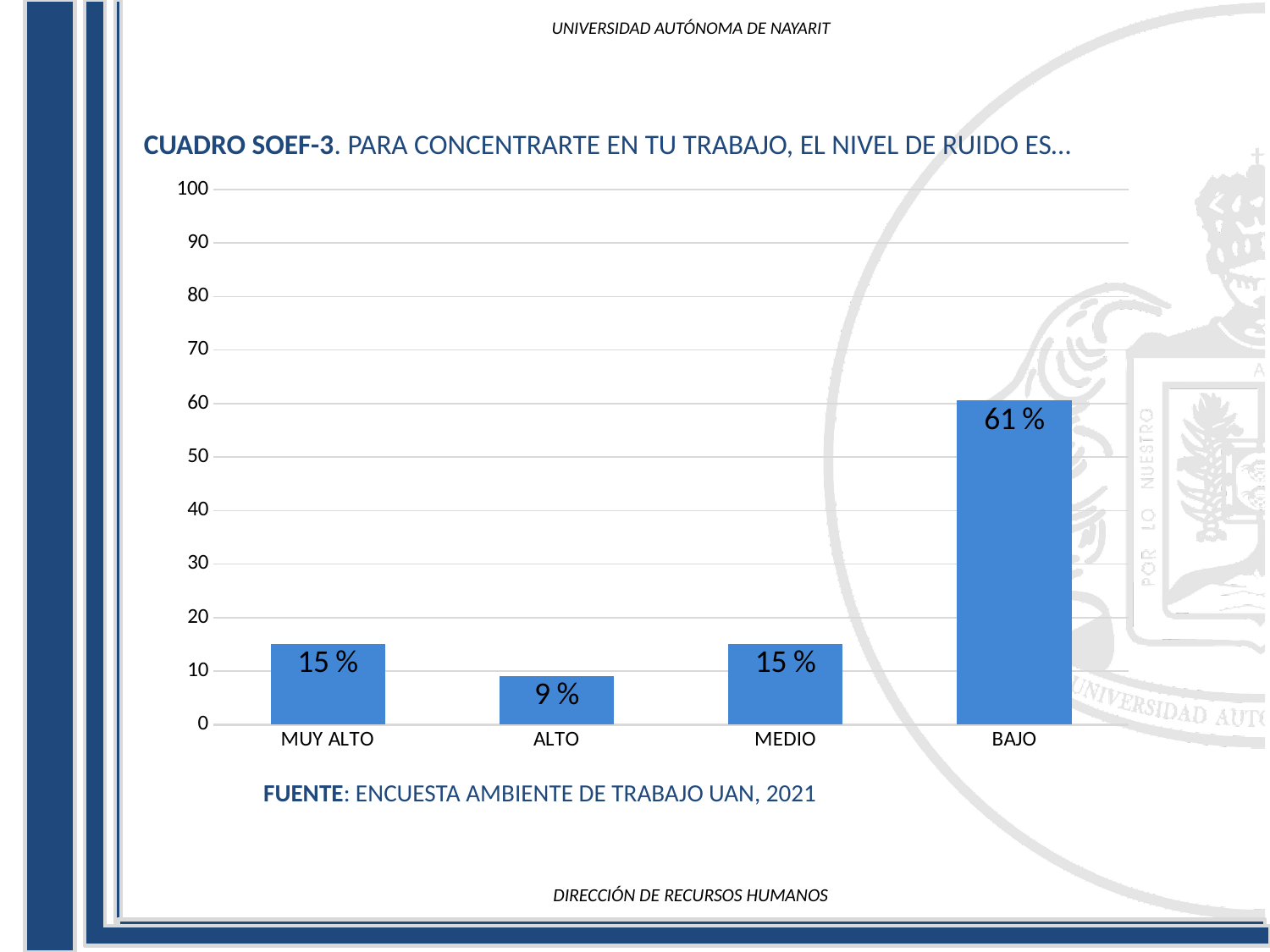
Is the value for BAJO greater or less than 50? greater Which category has the lowest value? ALTO What is the value for ALTO? 9 % What is the value for MEDIO? 15 % What is the value for BAJO? 61 % What is the value for MUY ALTO? 15 % What kind of chart is shown on the slide? bar chart Which is larger, the value for MEDIO or the value for ALTO? MEDIO How many categories are shown on the x axis? 4 Which category has the highest value? BAJO What source is cited below the chart? ENCUESTA AMBIENTE DE TRABAJO UAN, 2021 What is the difference between the values for BAJO and ALTO? 52 %